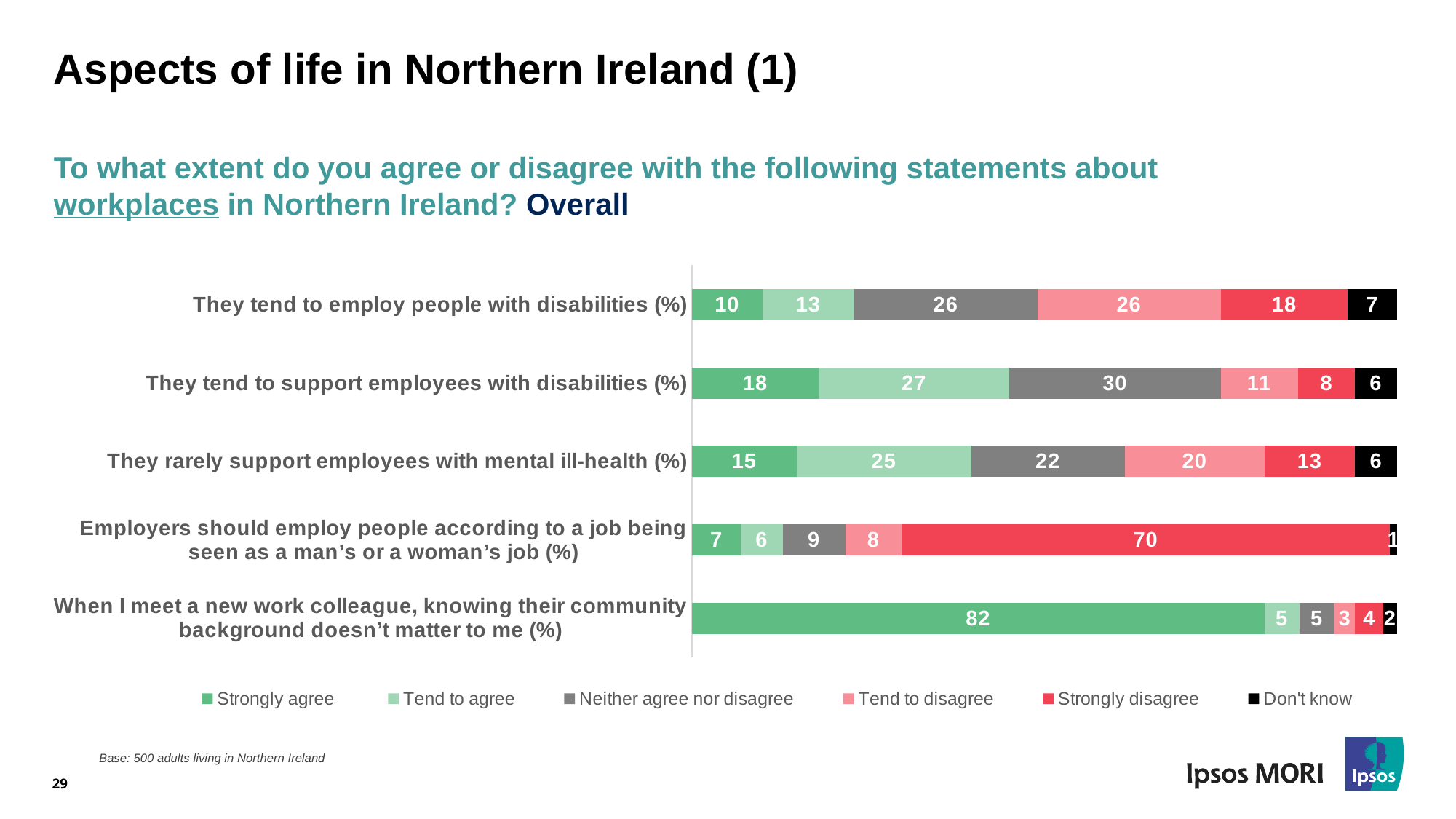
Which statement has the highest 'Strongly agree' value? When I meet a new work colleague, knowing their community background doesn't matter to me How many statements are shown in the chart? 5 What is the 'Neither agree nor disagree' value for 'They tend to support employees with disabilities'? 30 What kind of chart is shown on the slide? Stacked bar chart What is the 'Don't know' value for 'They tend to employ people with disabilities'? 7 What is the 'Strongly disagree' value for 'They rarely support employees with mental ill-health'? 13 What percentage strongly agree that employers should employ people according to a job being seen as a man's or a woman's job? 7 What is the total of the stacked bar for 'They tend to support employees with disabilities'? 100 What is the difference between the 'Strongly disagree' value for 'Employers should employ people according to a job being seen as a man's or a woman's job' and the 'Strongly disagree' value for 'They tend to employ people with disabilities'? 52 Which is larger: the 'Tend to disagree' value for 'They tend to employ people with disabilities' or for 'They tend to support employees with disabilities'? They tend to employ people with disabilities Which statement has the lowest 'Tend to agree' value? When I meet a new work colleague, knowing their community background doesn't matter to me How many series does the legend list? 6